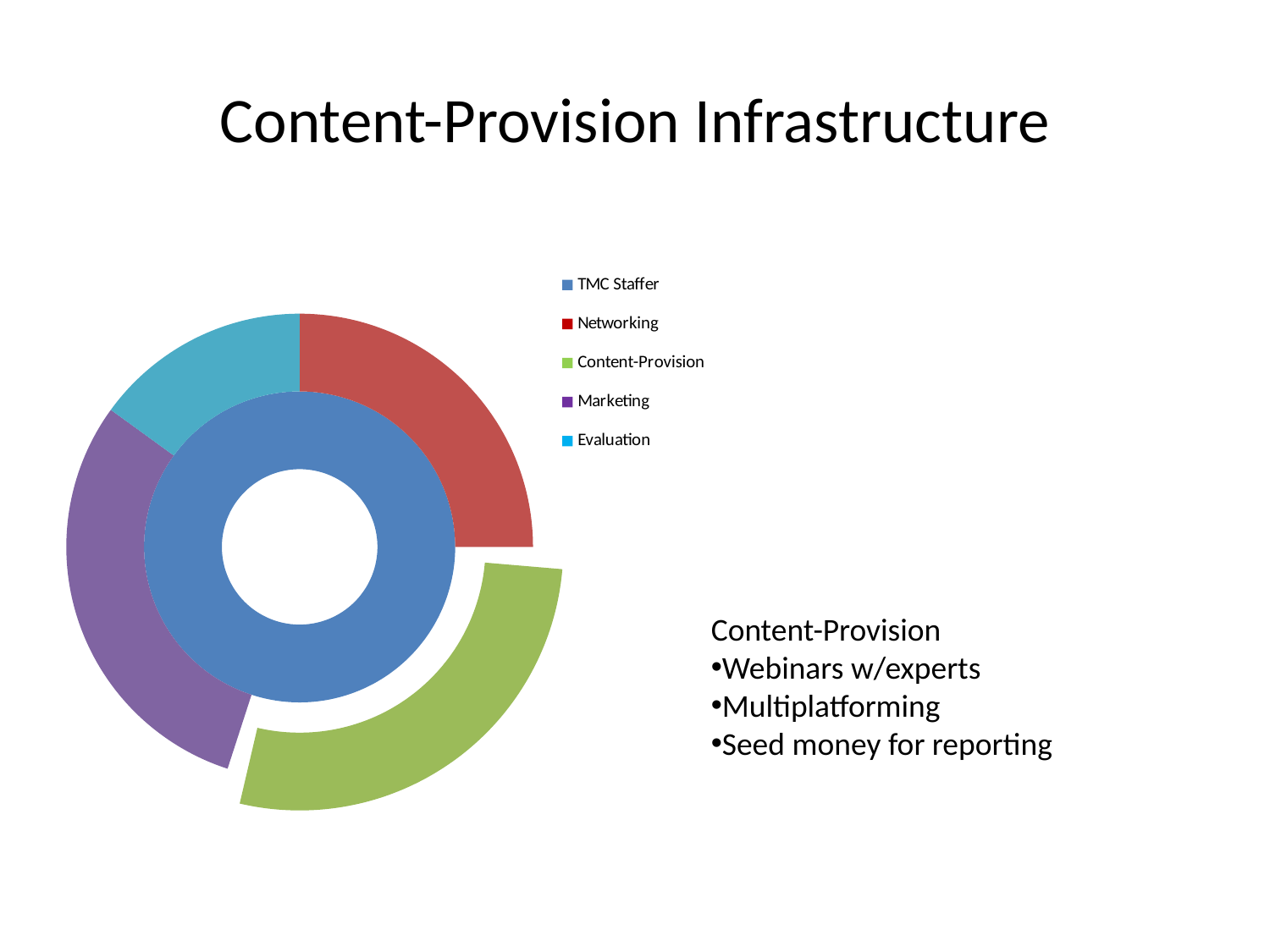
In the outer ring, which segment is larger: Networking or Evaluation? Networking How many categories does the legend list? 5 Which category has the smallest segment in the outer ring? Evaluation Which category fills the entire inner ring of the chart? TMC Staffer In the outer ring, which segment is larger: Marketing or Evaluation? Marketing In the outer ring, which segment is larger: Content-Provision or Evaluation? Content-Provision What kind of chart is shown on the slide? Doughnut chart Which segment of the outer ring is pulled out (exploded) from the rest of the chart? Content-Provision